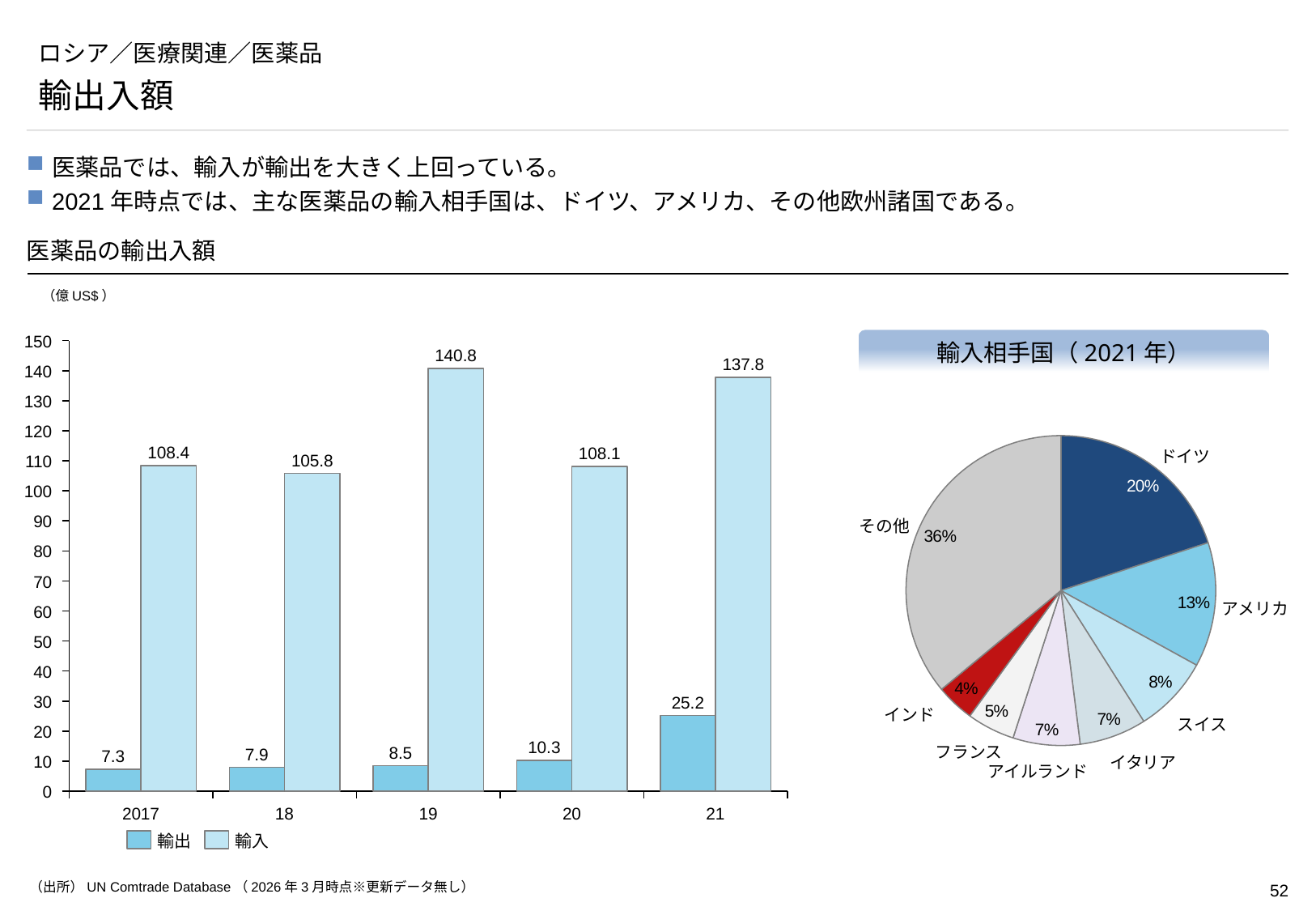
In the bar chart 医薬品の輸出入額, what is the difference between 輸入 and 輸出 in 2021? 112.6 In the bar chart 医薬品の輸出入額, does the 輸出 series rise or fall from 2017 to 2021? rise In the bar chart 医薬品の輸出入額, which year has the highest 輸入 value? 2019 In the bar chart 医薬品の輸出入額, what is the value of 輸出 for 2021? 25.2 In the bar chart 医薬品の輸出入額, what is the value of 輸入 for 2019? 140.8 In the pie chart 輸入相手国（2021年）, what share does ドイツ have? 20% In the pie chart 輸入相手国（2021年）, which named country (excluding その他) has the smallest share? インド What type of chart is 医薬品の輸出入額? bar chart In the bar chart 医薬品の輸出入額, which year has the lowest 輸出 value? 2017 In the bar chart 医薬品の輸出入額, is the 輸入 value for 2018 larger or smaller than the 輸入 value for 2020? smaller In the bar chart 医薬品の輸出入額, how many years are shown on the x axis? 5 In the bar chart 医薬品の輸出入額, how many series does the legend list? 2